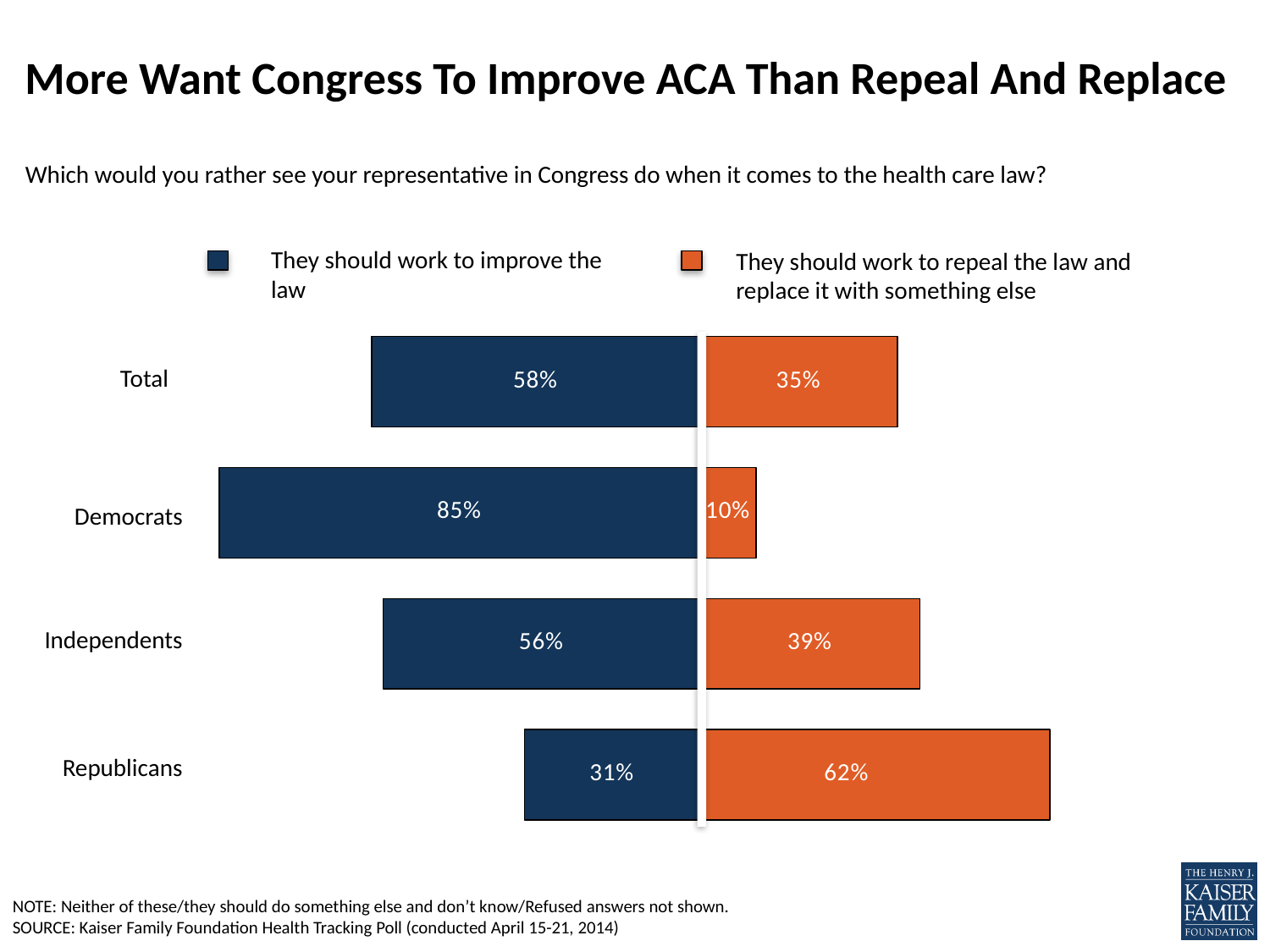
Which group has the lowest value for 'They should work to repeal the law and replace it with something else'? Democrats What colour represents 'They should work to repeal the law and replace it with something else'? Orange What percentage of Republicans say their representative should work to repeal the law and replace it with something else? 62% What percentage of Democrats say their representative should work to improve the law? 85% What is the value for Total in the 'They should work to repeal the law and replace it with something else' series? 35% How many groups are shown on the chart? 4 How many series does the legend list? 2 For Independents, which is larger: the share who want Congress to improve the law or the share who want it to repeal and replace the law? Improve the law What is the difference between the 'improve the law' and 'repeal and replace' values for Republicans? 31% Which group has the highest value for 'They should work to improve the law'? Democrats What is the value for Independents in the 'They should work to improve the law' series? 56% What kind of chart is shown on the slide? Bar chart